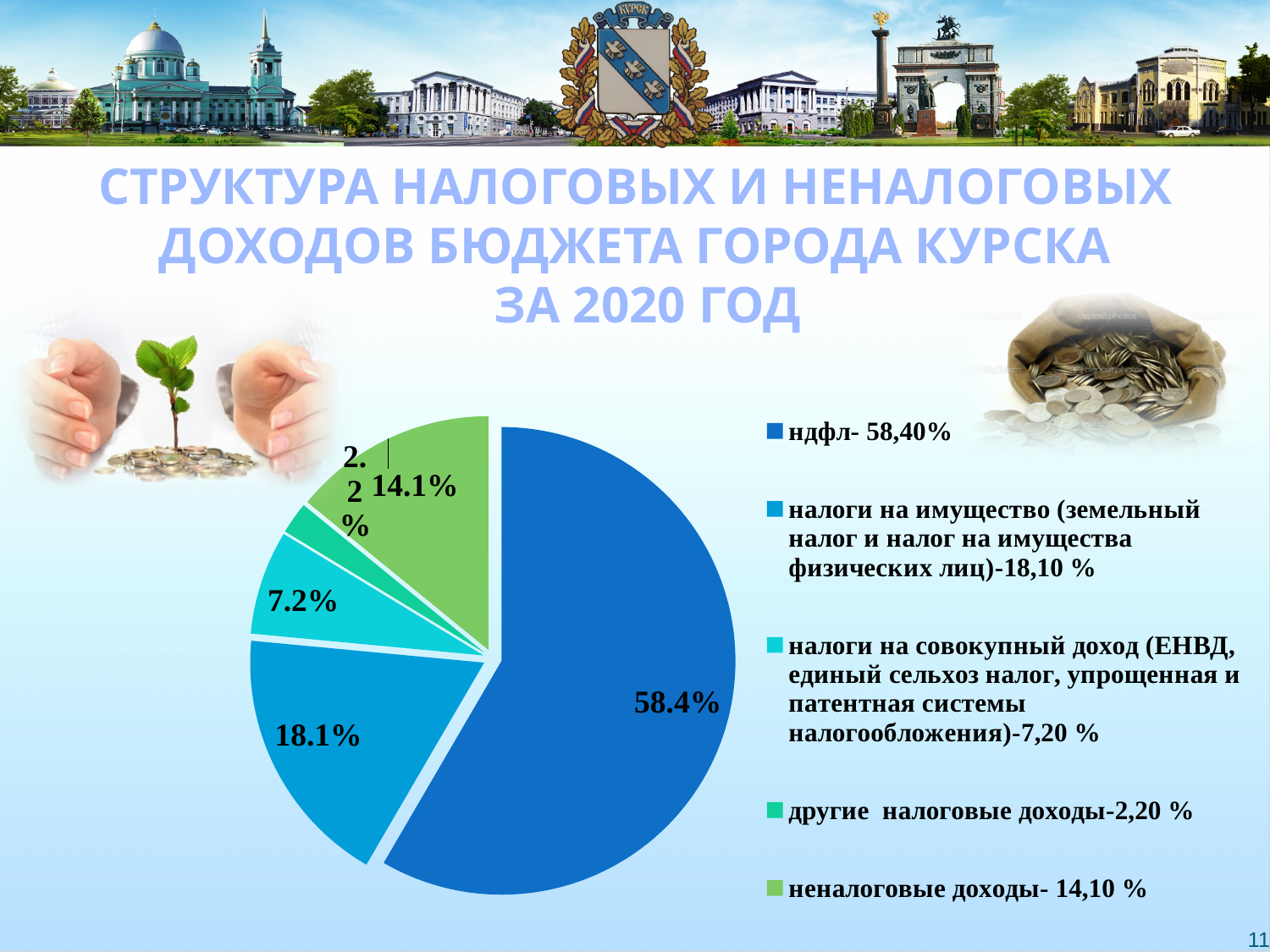
What kind of chart is shown on the slide? pie chart What is the value shown for налоги на совокупный доход? 7.2% Which is larger: the slice for неналоговые доходы or the slice for налоги на совокупный доход? неналоговые доходы How many entries does the legend list? 5 How many slices does the pie chart have? 5 What is the difference in percentage points between НДФЛ and налоги на имущество? 40.3 What is the value shown for неналоговые доходы? 14.1% What share of the pie does НДФЛ account for? 58.4% Which category has the smallest slice of the pie? другие налоговые доходы What is the value shown for налоги на имущество? 18.1% What is the value shown for другие налоговые доходы? 2.2% Which category has the largest slice of the pie? НДФЛ